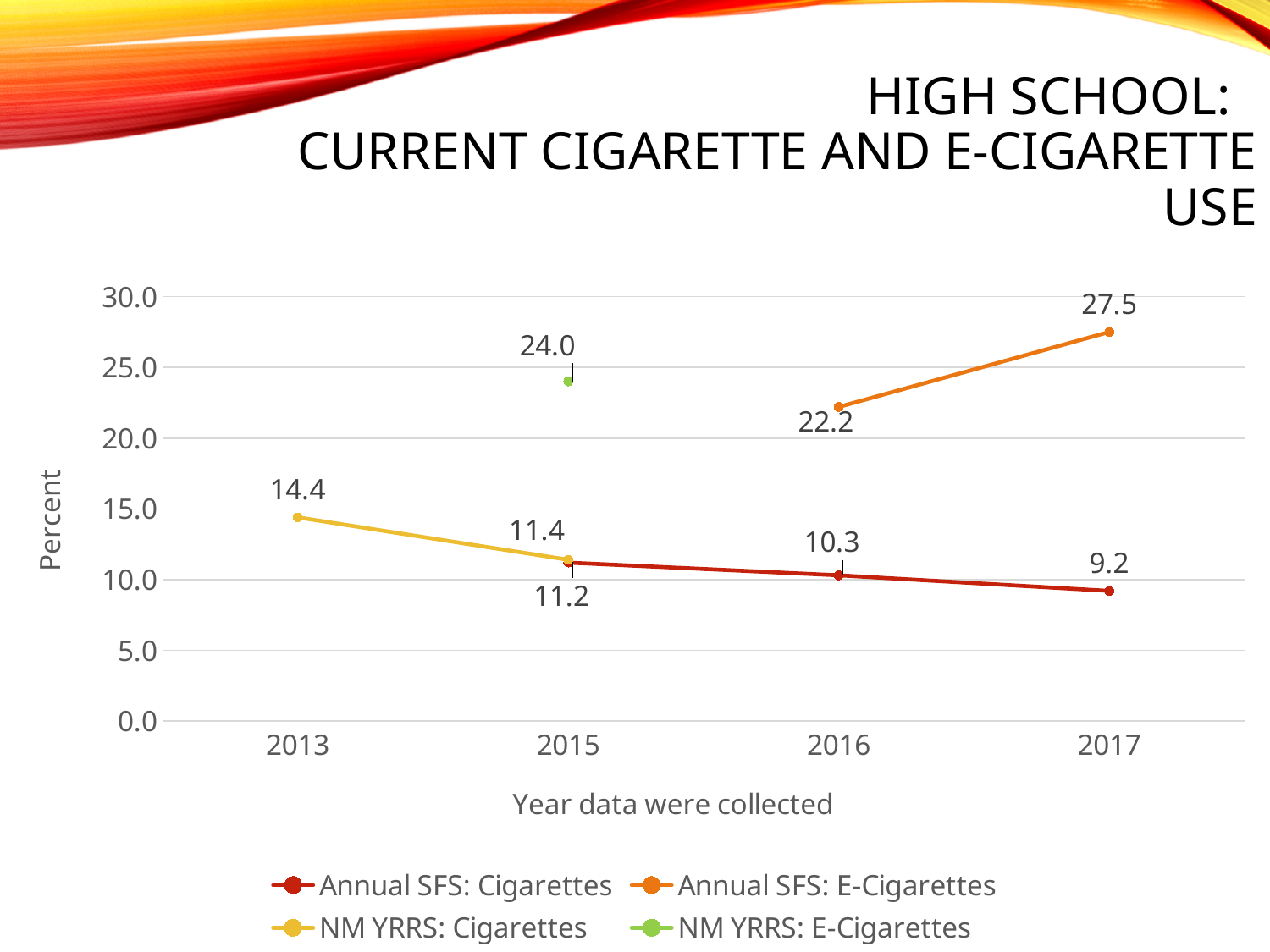
What type of chart is shown on the slide? line chart What is the difference between the NM YRRS: Cigarettes values for 2013 and 2015? 3.0 What is the value for Annual SFS: Cigarettes in 2017? 9.2 What is the value for NM YRRS: Cigarettes in 2013? 14.4 What is the value for NM YRRS: E-Cigarettes in 2015? 24.0 Does the Annual SFS: Cigarettes series rise or fall from 2015 to 2017? fall How many series does the legend list? 4 What is the value for Annual SFS: E-Cigarettes in 2016? 22.2 Which is larger in 2016: Annual SFS: E-Cigarettes or Annual SFS: Cigarettes? Annual SFS: E-Cigarettes What is the difference between the Annual SFS: E-Cigarettes values for 2017 and 2016? 5.3 What is the value for Annual SFS: E-Cigarettes in 2017? 27.5 In which year is the Annual SFS: Cigarettes value lowest? 2017